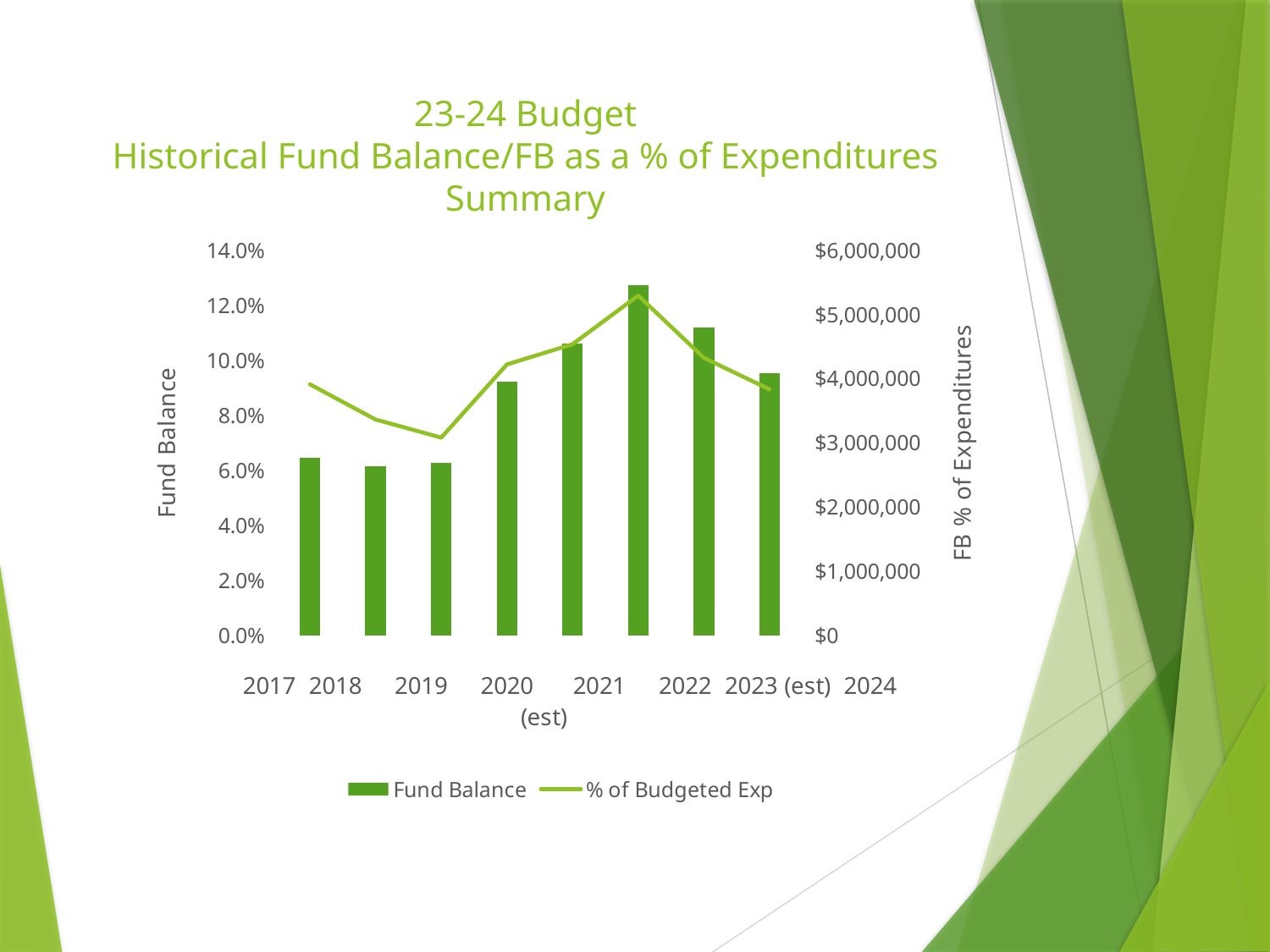
Is the % of Budgeted Exp value for 2022 greater or less than 12.0% on the left axis? greater Does the % of Budgeted Exp line rise or fall from 2019 to 2022? rise Which year has the tallest Fund Balance bar? 2022 Which year has the lowest point on the % of Budgeted Exp line? 2019 What are the two series named in the legend? Fund Balance and % of Budgeted Exp Which year has the highest point on the % of Budgeted Exp line? 2022 How many series does the legend list? 2 What kind of chart is shown on the slide? A combination bar and line chart Which year has the shortest Fund Balance bar? 2018 Is the % of Budgeted Exp value for 2019 greater or less than 8.0% on the left axis? less Do the Fund Balance bars rise or fall from 2022 to 2024? fall How many bars are plotted in the chart? 8